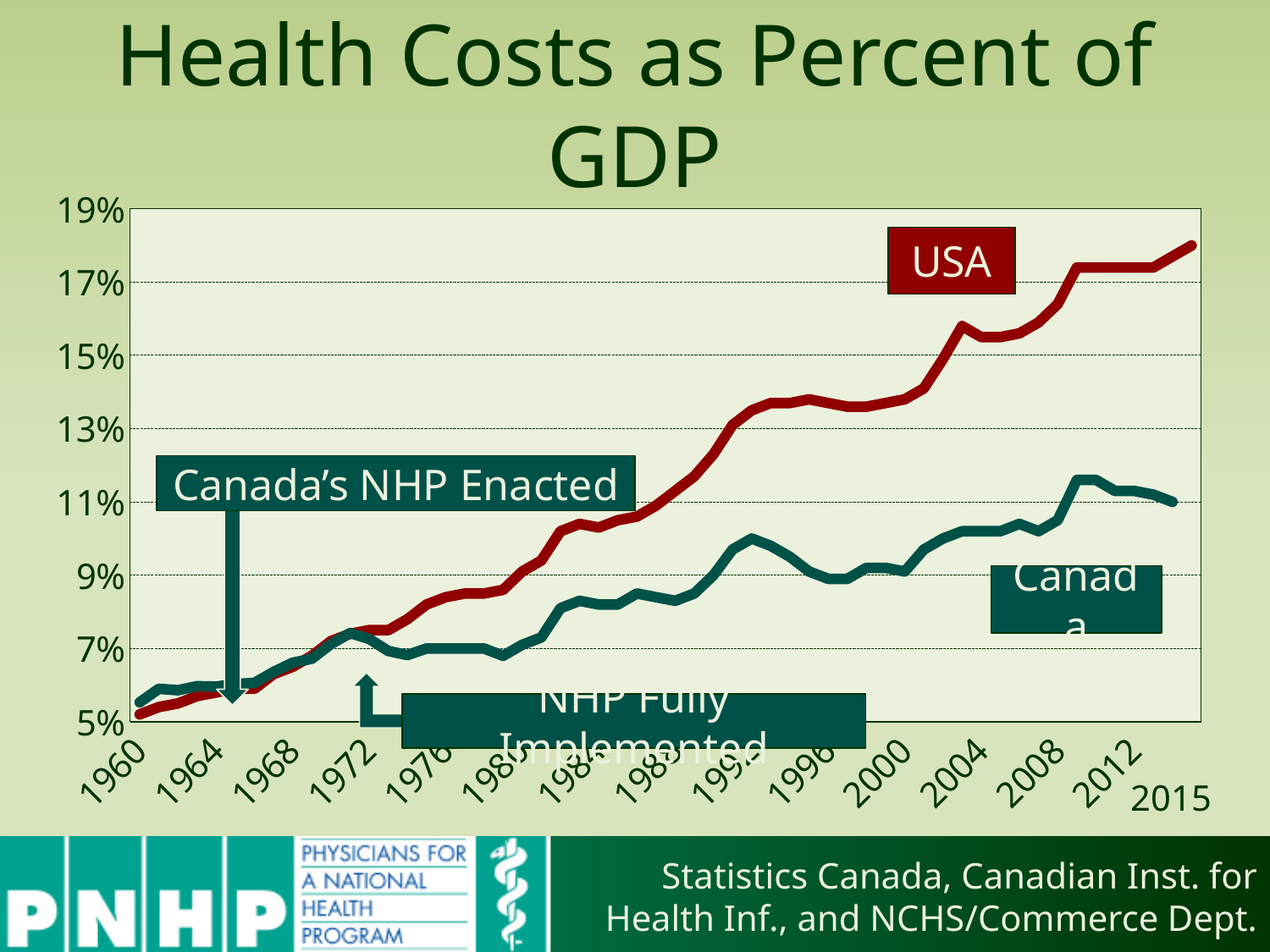
Which series is drawn in dark red? USA What kind of chart is shown on the slide? line chart Is the value for Canada in 1980 greater or less than 9%? less Does the USA series generally rise or fall from 1960 to 2015? rise Which series has the higher value in 2000, USA or Canada? USA Is the value for USA in 2015 greater or less than 17%? greater What is the title of the chart? Health Costs as Percent of GDP Which series has the higher value in 2015, USA or Canada? USA Is the value for USA in 1960 greater or less than 7%? less How many series are plotted on the chart? 2